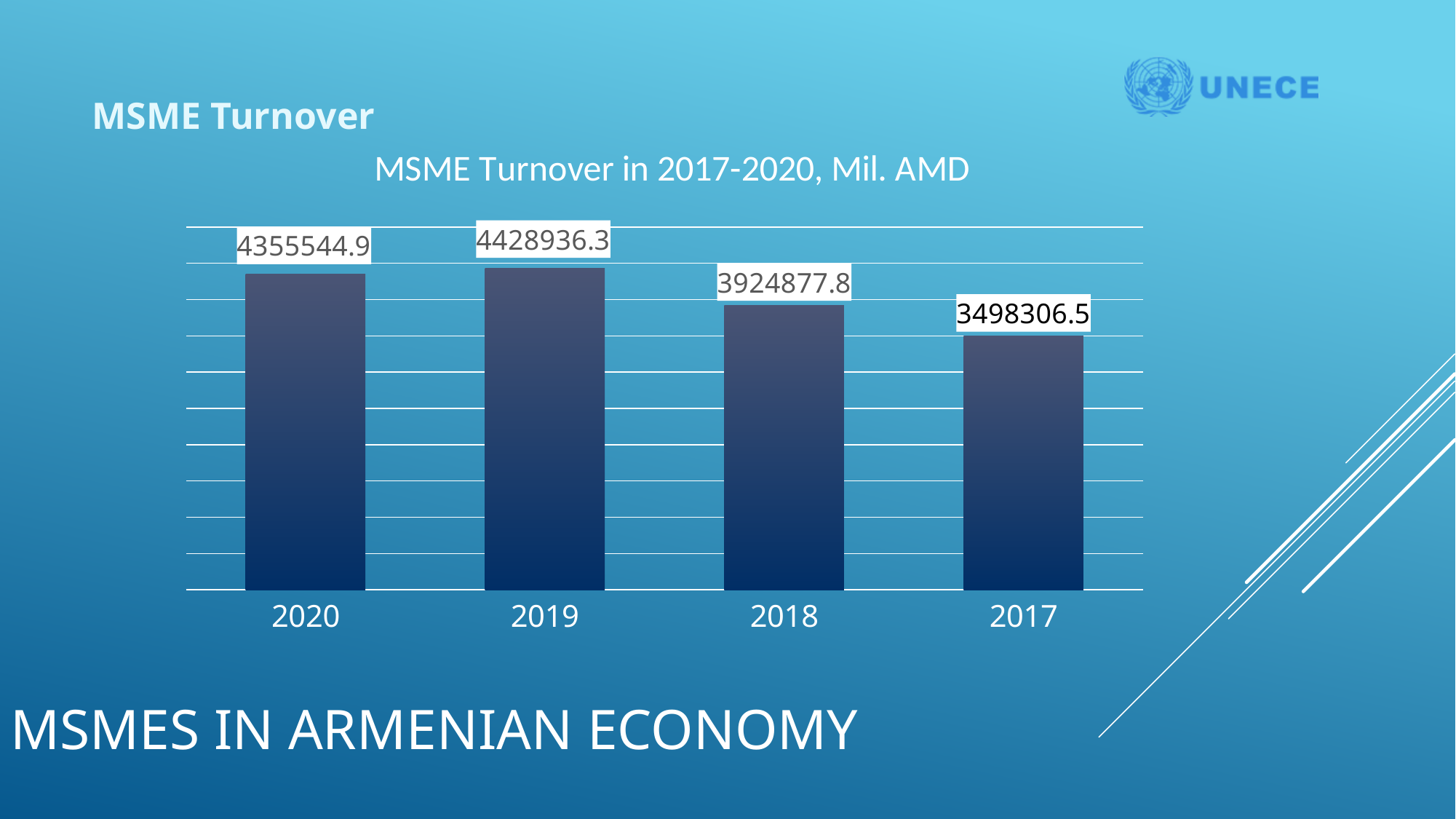
Which is larger, the MSME turnover for 2018 or for 2017? 2018 What is the difference between the MSME turnover for 2019 and for 2020? 73391.4 What is the title of the chart? MSME Turnover in 2017-2020, Mil. AMD What is the MSME turnover value for 2020? 4355544.9 What is the MSME turnover value for 2017? 3498306.5 Which year has the lowest MSME turnover? 2017 Which year has the highest MSME turnover? 2019 How many years are shown on the x axis of the chart? 4 Do the values generally rise or fall moving left to right along the x axis from 2020 to 2017? fall What is the MSME turnover value for 2019? 4428936.3 What is the MSME turnover value for 2018? 3924877.8 What type of chart is shown on the slide? bar chart